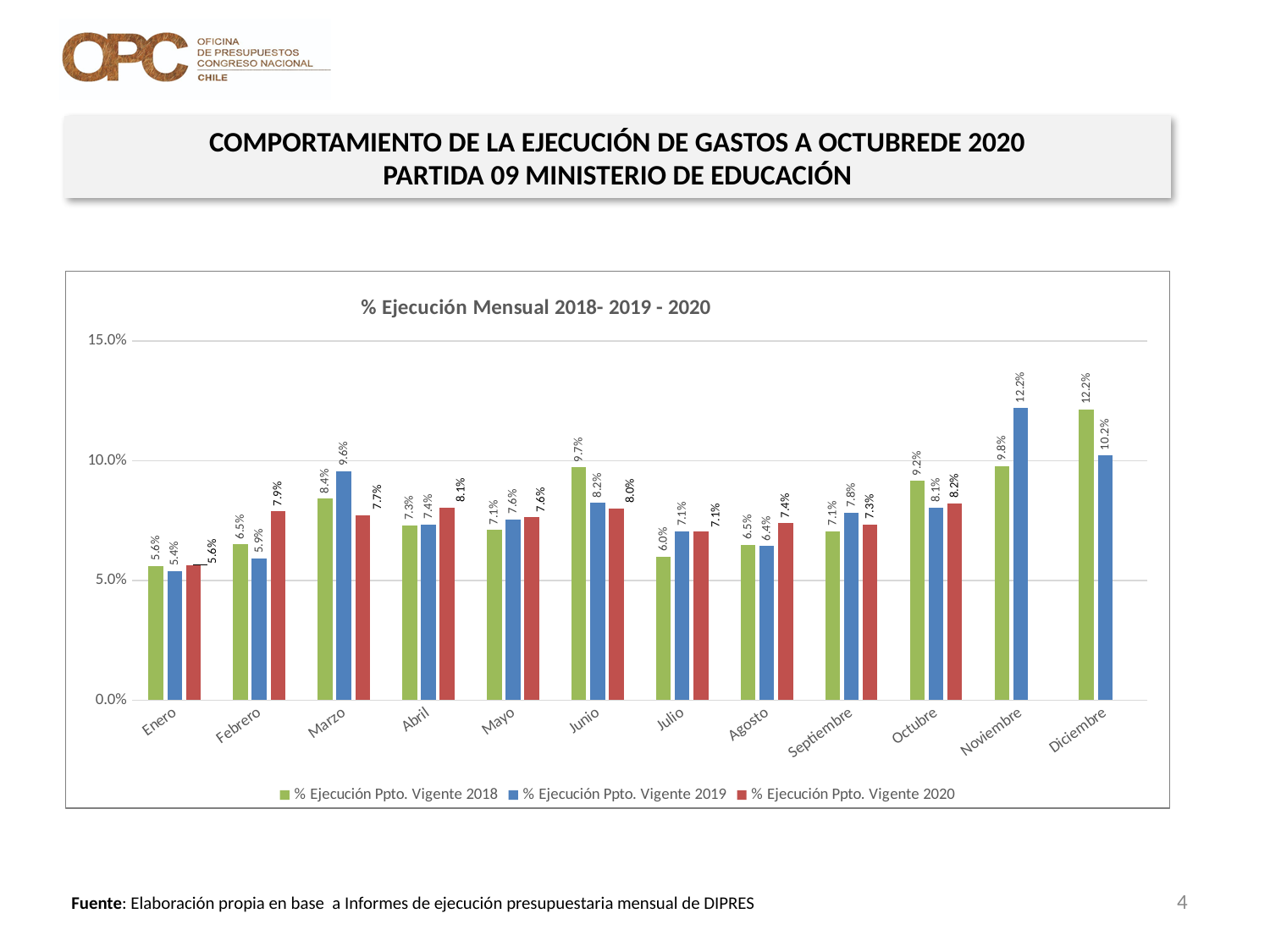
Is the value for % Ejecución Ppto. Vigente 2018 in Noviembre greater or less than 10.0%? less What is the value for % Ejecución Ppto. Vigente 2019 in Noviembre? 12.2% What is the title of the chart? % Ejecución Mensual 2018- 2019 - 2020 What is the difference between the 2019 and 2018 values in Marzo? 1.2% Which is larger in Febrero: the 2018 value or the 2020 value? 2020 value Which month has the lowest value for % Ejecución Ppto. Vigente 2019? Enero Which month has the highest value for % Ejecución Ppto. Vigente 2018? Diciembre What is the value for % Ejecución Ppto. Vigente 2020 in Marzo? 7.7% What is the value for % Ejecución Ppto. Vigente 2018 in Junio? 9.7% How many months are shown on the x axis? 12 How many series does the legend list? 3 What kind of chart is shown on the slide? Bar chart